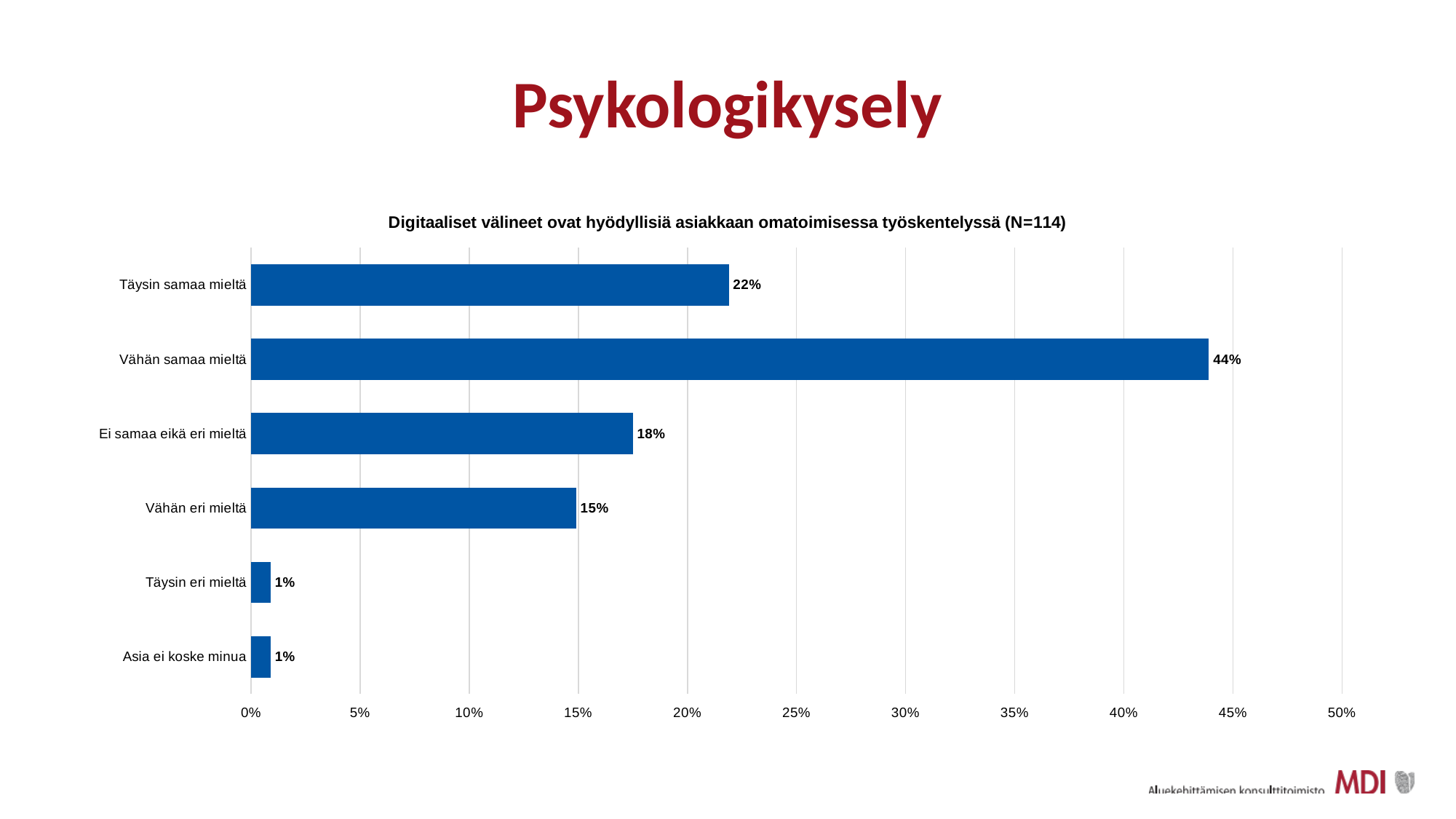
What is the value for "Vähän samaa mieltä"? 44% What is the difference between the values for "Ei samaa eikä eri mieltä" and "Vähän eri mieltä"? 3% What is the title of the chart? Digitaaliset välineet ovat hyödyllisiä asiakkaan omatoimisessa työskentelyssä (N=114) Which category has the highest value? Vähän samaa mieltä Which is larger, the value for "Täysin samaa mieltä" or the value for "Ei samaa eikä eri mieltä"? Täysin samaa mieltä What is the difference between the values for "Vähän samaa mieltä" and "Täysin samaa mieltä"? 22% How many categories are shown in the chart? 6 Is the value for "Vähän samaa mieltä" greater or less than 40%? greater What kind of chart is shown on the slide? Bar chart What is the value for "Ei samaa eikä eri mieltä"? 18% What is the value for "Vähän eri mieltä"? 15% What is the value for "Täysin samaa mieltä"? 22%